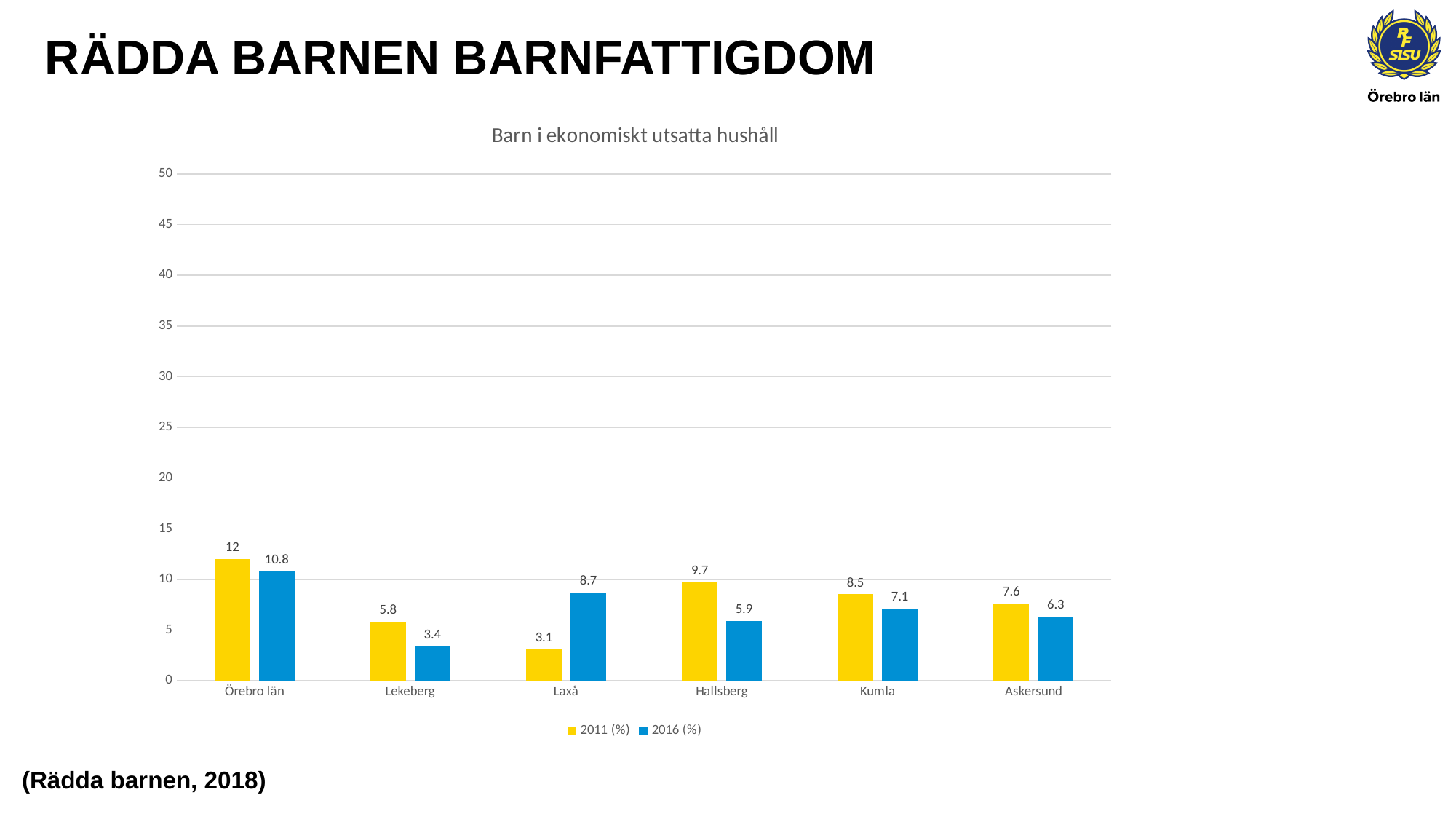
What is the title of the chart? Barn i ekonomiskt utsatta hushåll What kind of chart is shown? bar chart What is the 2016 (%) value for Lekeberg? 3.4 Is the 2011 (%) value for Kumla greater or less than 10? less What is the 2016 (%) value for Laxå? 8.7 What is the 2011 (%) value for Örebro län? 12 Which category has the lowest 2016 (%) value? Lekeberg Which category has the highest 2011 (%) value? Örebro län Which is larger for Laxå, the 2011 (%) value or the 2016 (%) value? 2016 (%) How many series does the legend list? 2 What is the difference between the 2011 (%) and 2016 (%) values for Hallsberg? 3.8 How many categories are shown on the x axis? 6